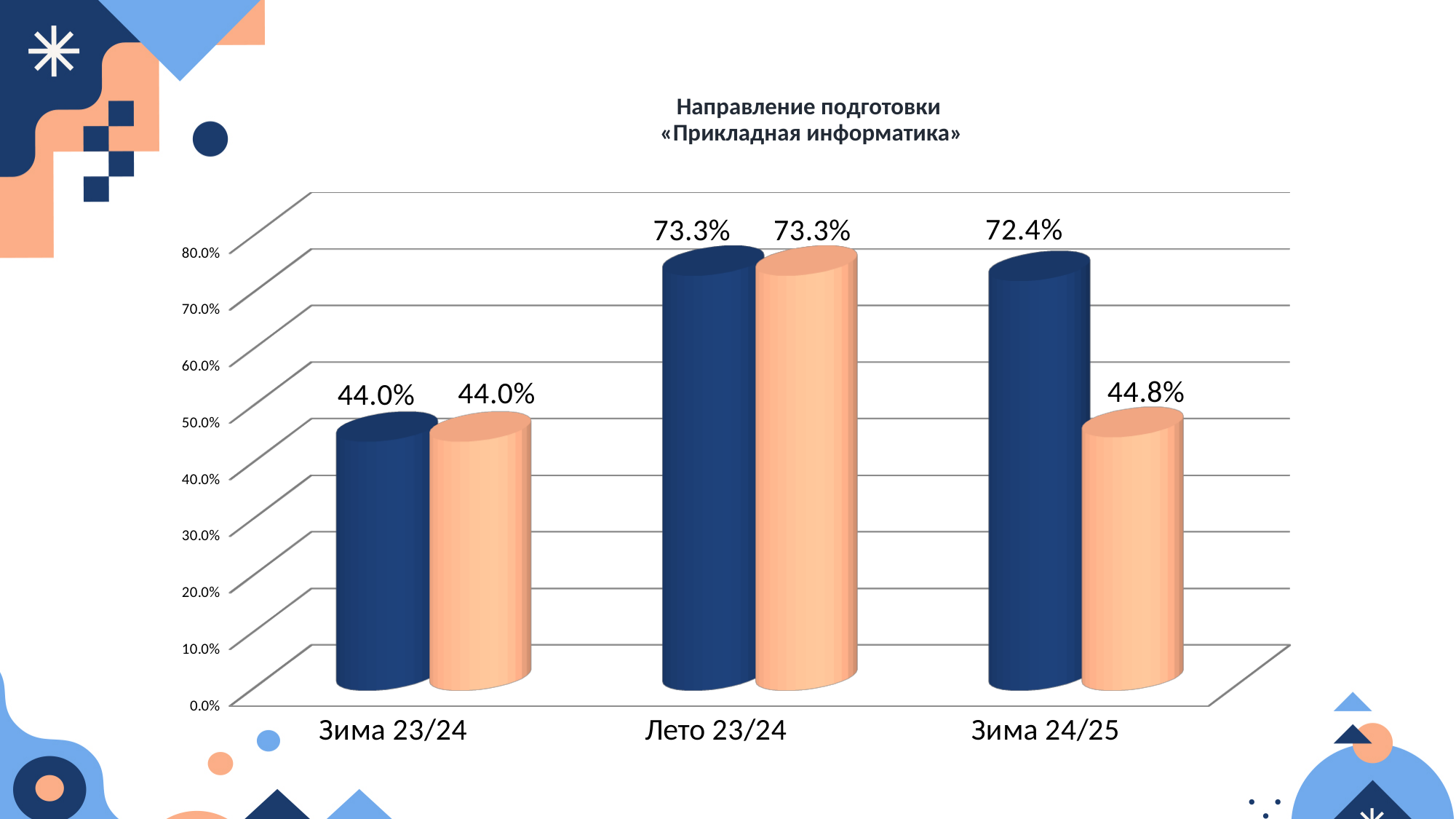
Which category has the highest value for the orange bars? Лето 23/24 What is the title of the chart? Направление подготовки «Прикладная информатика» How many categories are shown on the x axis? 3 What is the difference between the orange bar for Зима 24/25 and the orange bar for Зима 23/24? 0.8% What is the difference between the dark blue bar and the orange bar for Зима 24/25? 27.6% What is the value of the orange bar for Зима 24/25? 44.8% Which category has the lowest value for the dark blue bars? Зима 23/24 What is the value of the dark blue bar for Лето 23/24? 73.3% What is the value of the orange bar for Зима 23/24? 44.0% For Зима 24/25, which is larger: the dark blue bar or the orange bar? the dark blue bar What is the value of the dark blue bar for Зима 24/25? 72.4% What kind of chart is shown on the slide? bar chart